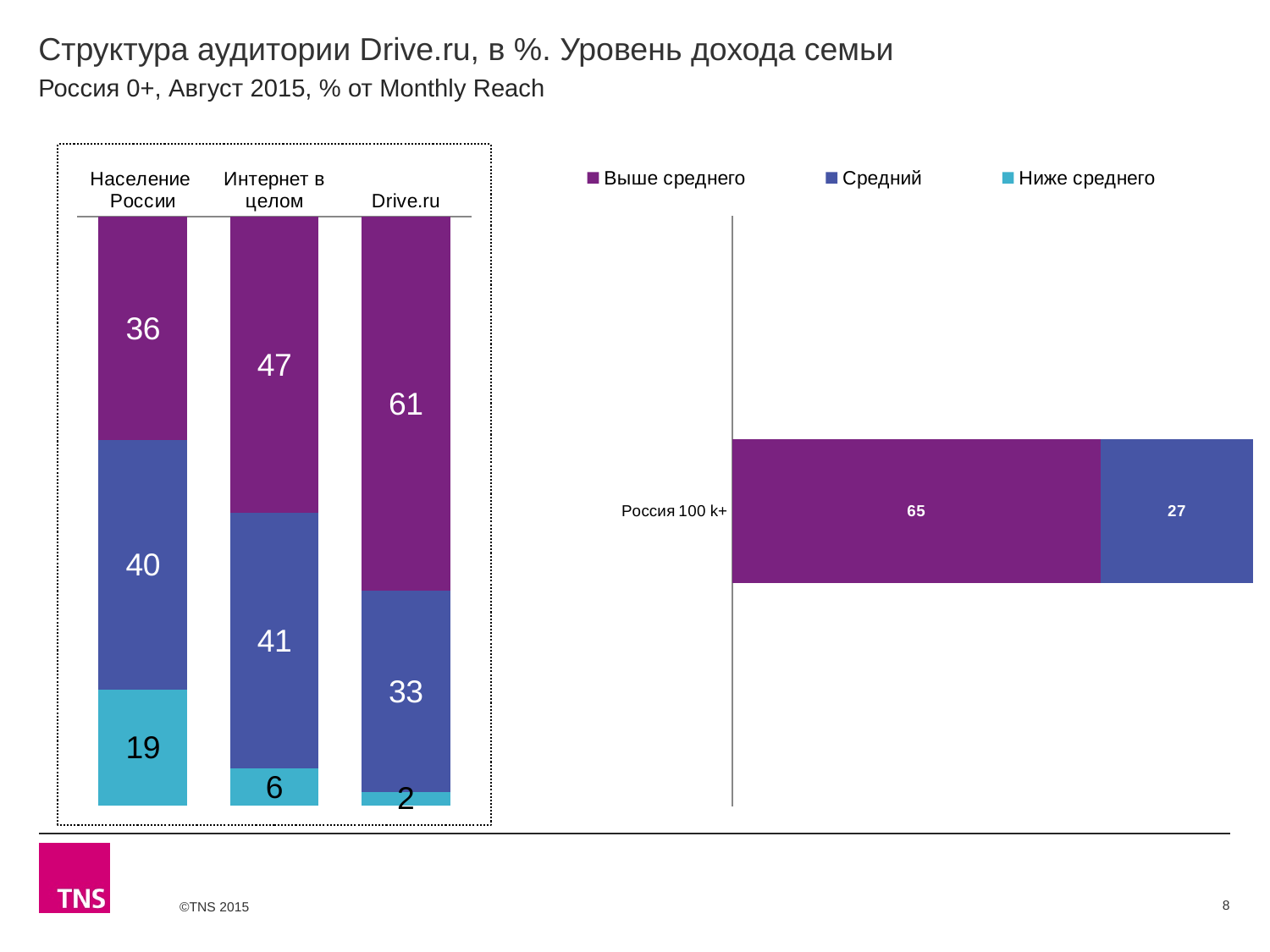
In the left stacked bar chart, which category has the highest 'Выше среднего' value? Drive.ru How many categories are shown on the x axis of the left stacked bar chart? 3 In the left stacked bar chart, what is the total of the three segments for 'Интернет в целом'? 94 In the left stacked bar chart, what is the value of the 'Средний' segment for 'Интернет в целом'? 41 In the left stacked bar chart, which category has the lowest 'Ниже среднего' value? Drive.ru In the left stacked bar chart, which is larger: the 'Средний' value for 'Население России' or for Drive.ru? Население России How many series does the legend list? 3 In the left stacked bar chart, what is the value of the 'Выше среднего' segment for Drive.ru? 61 In the right chart, what is the 'Средний' value for 'Россия 100 k+'? 27 In the left stacked bar chart, what is the difference between the 'Выше среднего' values for Drive.ru and 'Население России'? 25 In the right chart, what is the 'Выше среднего' value for 'Россия 100 k+'? 65 In the left stacked bar chart, what is the value of the 'Ниже среднего' segment for 'Население России'? 19